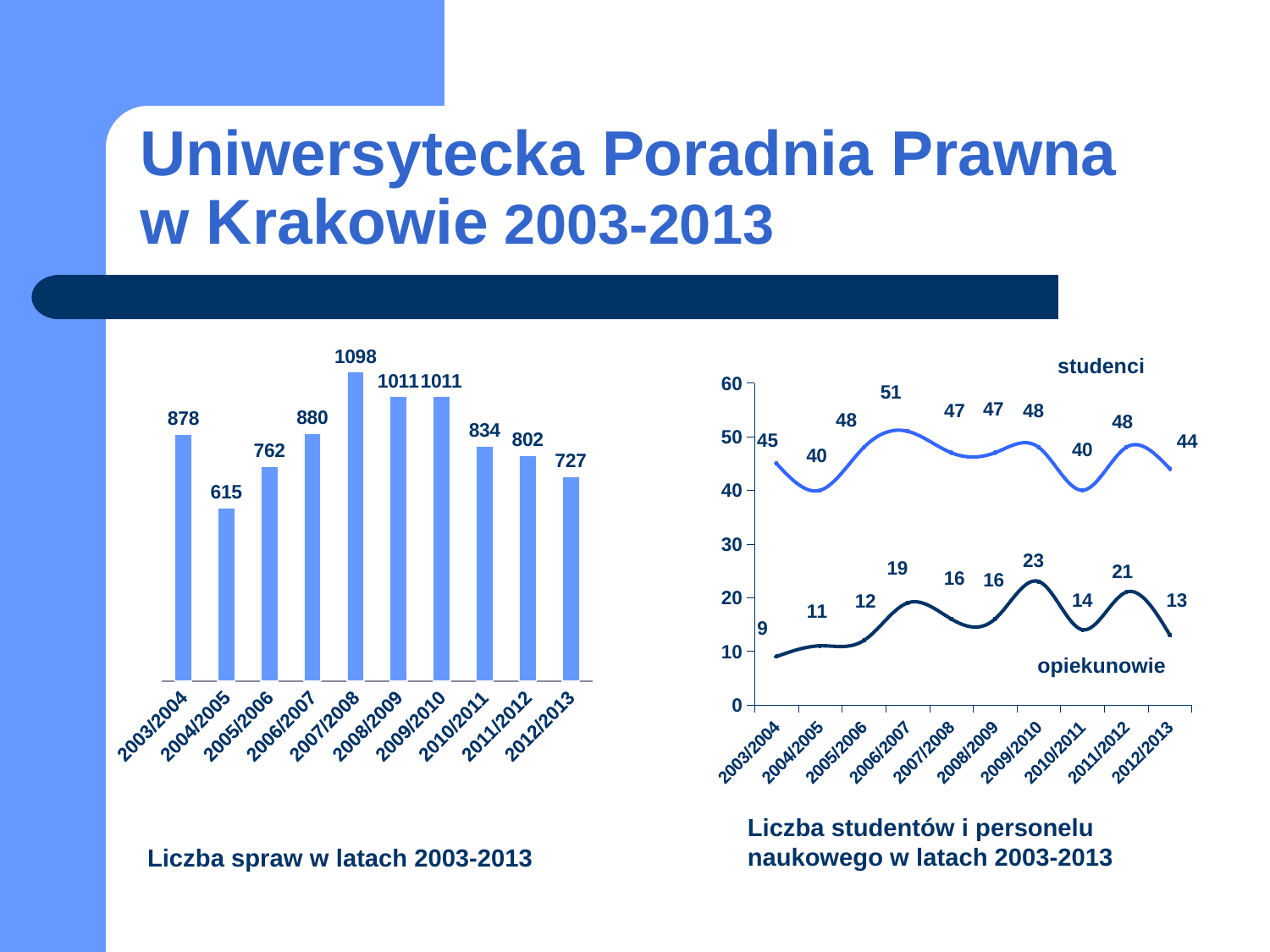
In the left chart (Liczba spraw w latach 2003-2013), what is the value for 2007/2008? 1098 In the right chart (Liczba studentów i personelu naukowego w latach 2003-2013), what is the value for studenci in 2006/2007? 51 In the right chart (Liczba studentów i personelu naukowego w latach 2003-2013), in which year is the opiekunowie value lowest? 2003/2004 In the right chart (Liczba studentów i personelu naukowego w latach 2003-2013), what is the difference between studenci and opiekunowie in 2012/2013? 31 In the left chart (Liczba spraw w latach 2003-2013), how many years are shown on the x axis? 10 In the left chart (Liczba spraw w latach 2003-2013), which year has the lowest value? 2004/2005 In the left chart (Liczba spraw w latach 2003-2013), what kind of chart is it? bar chart In the right chart (Liczba studentów i personelu naukowego w latach 2003-2013), what is the value for opiekunowie in 2009/2010? 23 In the right chart (Liczba studentów i personelu naukowego w latach 2003-2013), how many series are plotted? 2 In the left chart (Liczba spraw w latach 2003-2013), what is the difference between the values for 2007/2008 and 2012/2013? 371 In the left chart (Liczba spraw w latach 2003-2013), which is larger, the value for 2003/2004 or 2006/2007? 2006/2007 In the right chart (Liczba studentów i personelu naukowego w latach 2003-2013), what kind of chart is it? line chart